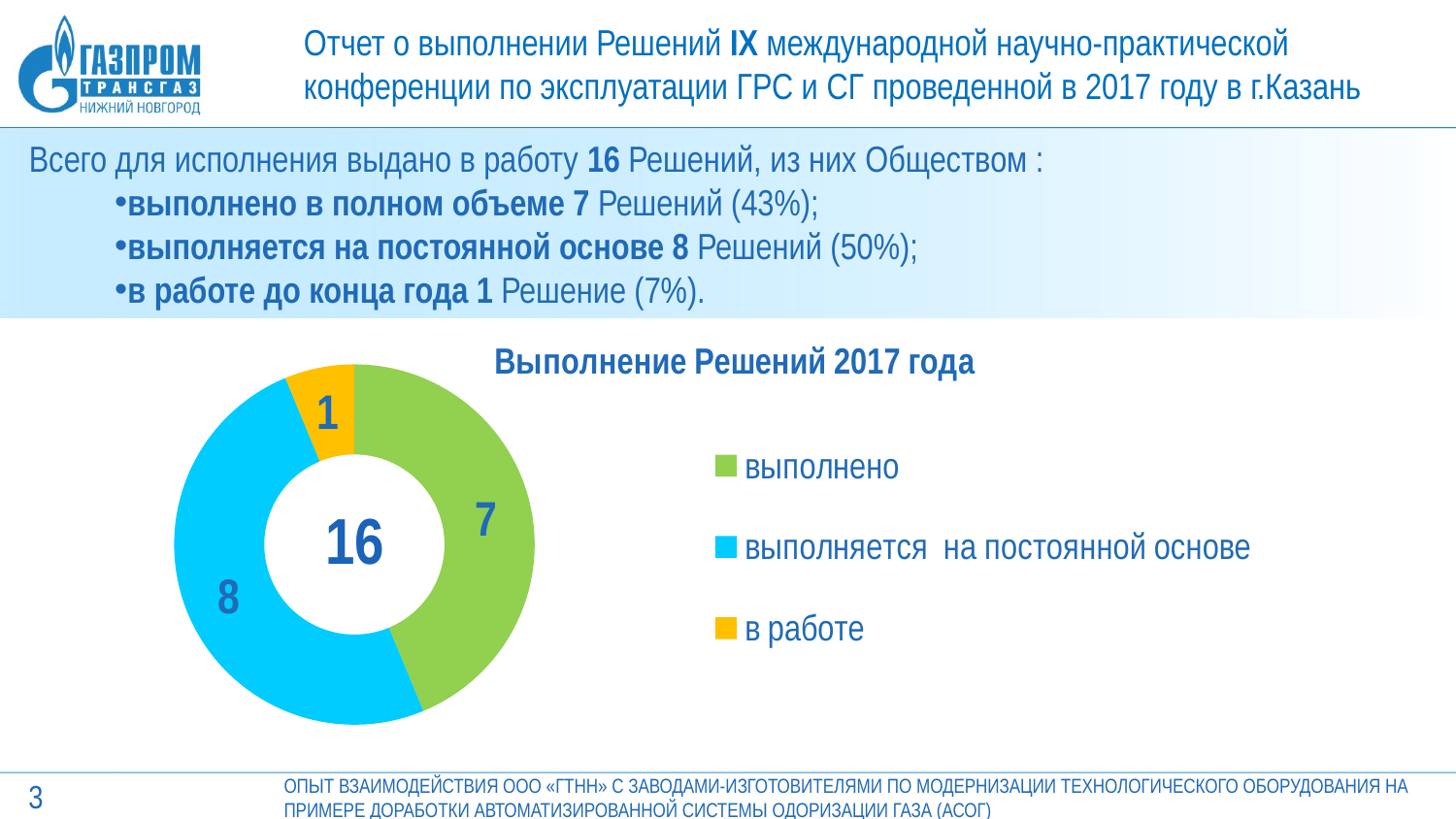
Which category has the largest slice in the chart? выполняется на постоянной основе What is the difference between the values for 'выполняется на постоянной основе' and 'выполнено'? 1 What is the title of the chart? Выполнение Решений 2017 года What share of the total does the slice 'выполняется на постоянной основе' represent? 50% What is the value for the slice 'выполняется на постоянной основе'? 8 How many series does the chart legend list? 3 What is the total shown in the centre of the doughnut chart? 16 What type of chart is shown on the slide? doughnut (pie) chart What is the value for the slice 'выполнено'? 7 Which category has the smallest slice in the chart? в работе What is the value for the slice 'в работе'? 1 How many slices does the doughnut chart have? 3